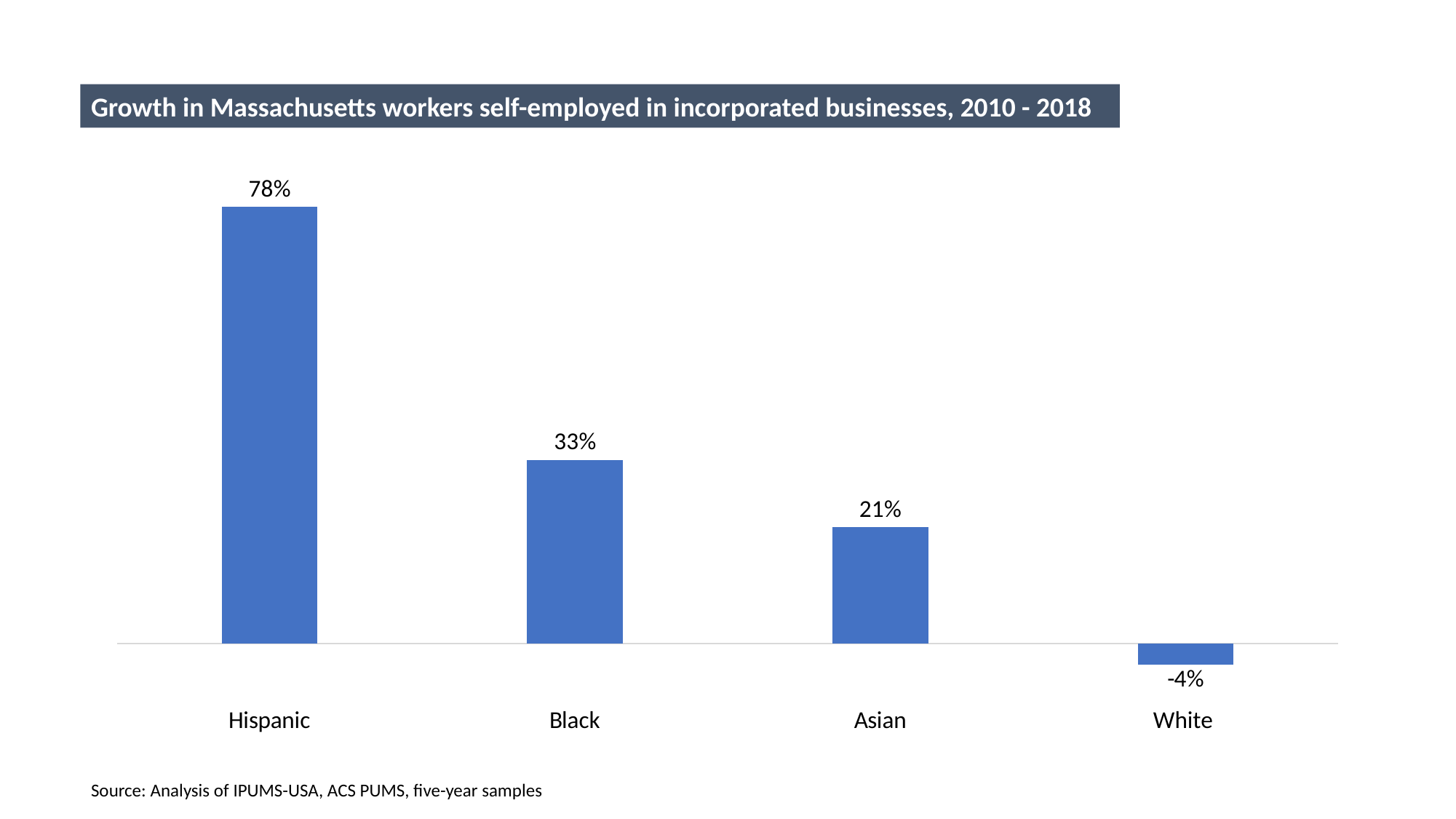
What is the difference between the growth values for Black and Asian workers? 12% What is the growth value shown for White workers? -4% What is the growth value shown for Black workers? 33% What kind of chart is shown on the slide? Bar chart Which group has the lowest growth in self-employment in incorporated businesses? White What is the title of the chart? Growth in Massachusetts workers self-employed in incorporated businesses, 2010 - 2018 What is the growth value shown for Asian workers? 21% What is the difference between the growth values for Hispanic and Black workers? 45% How many groups are shown on the chart? 4 Which group has a larger growth value, Asian or Black? Black Which group has the highest growth in self-employment in incorporated businesses? Hispanic What is the growth value shown for Hispanic workers? 78%